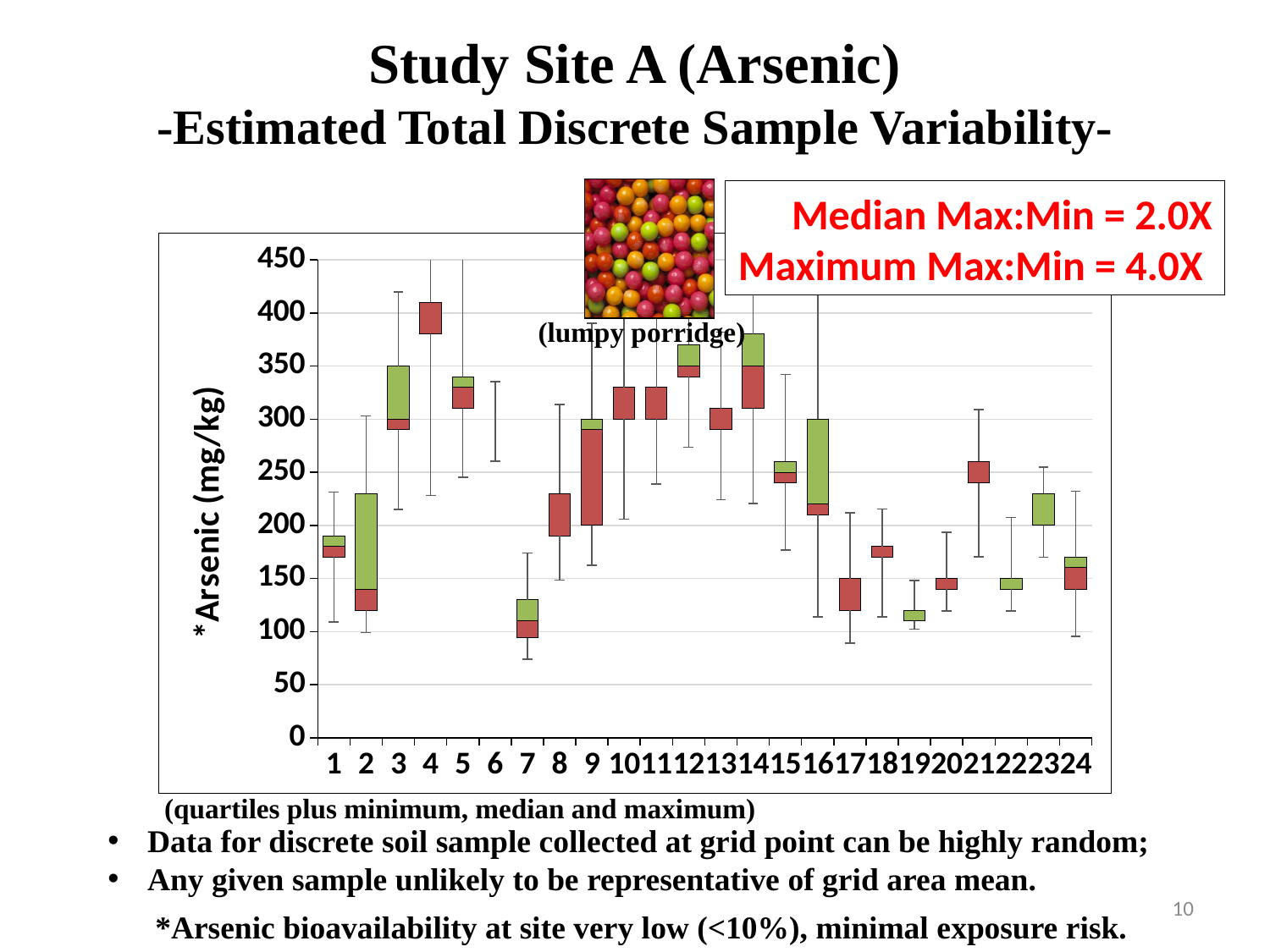
Which grid point has the box positioned highest on the y axis? 4 Which is positioned higher on the y axis, the box for grid point 12 or the box for grid point 19? Grid point 12 Is the box for grid point 1 greater or less than 200 mg/kg? less Is the box for grid point 4 greater or less than 350 mg/kg? greater How many grid points (categories) are plotted along the x axis? 24 What kind of chart is shown on the slide? Box-and-whisker (box plot) chart Is the box for grid point 14 greater or less than 300 mg/kg? greater Which is positioned higher on the y axis, the box for grid point 4 or the box for grid point 7? Grid point 4 What is the highest value shown on the y axis? 450 What is the label of the y axis? *Arsenic (mg/kg)